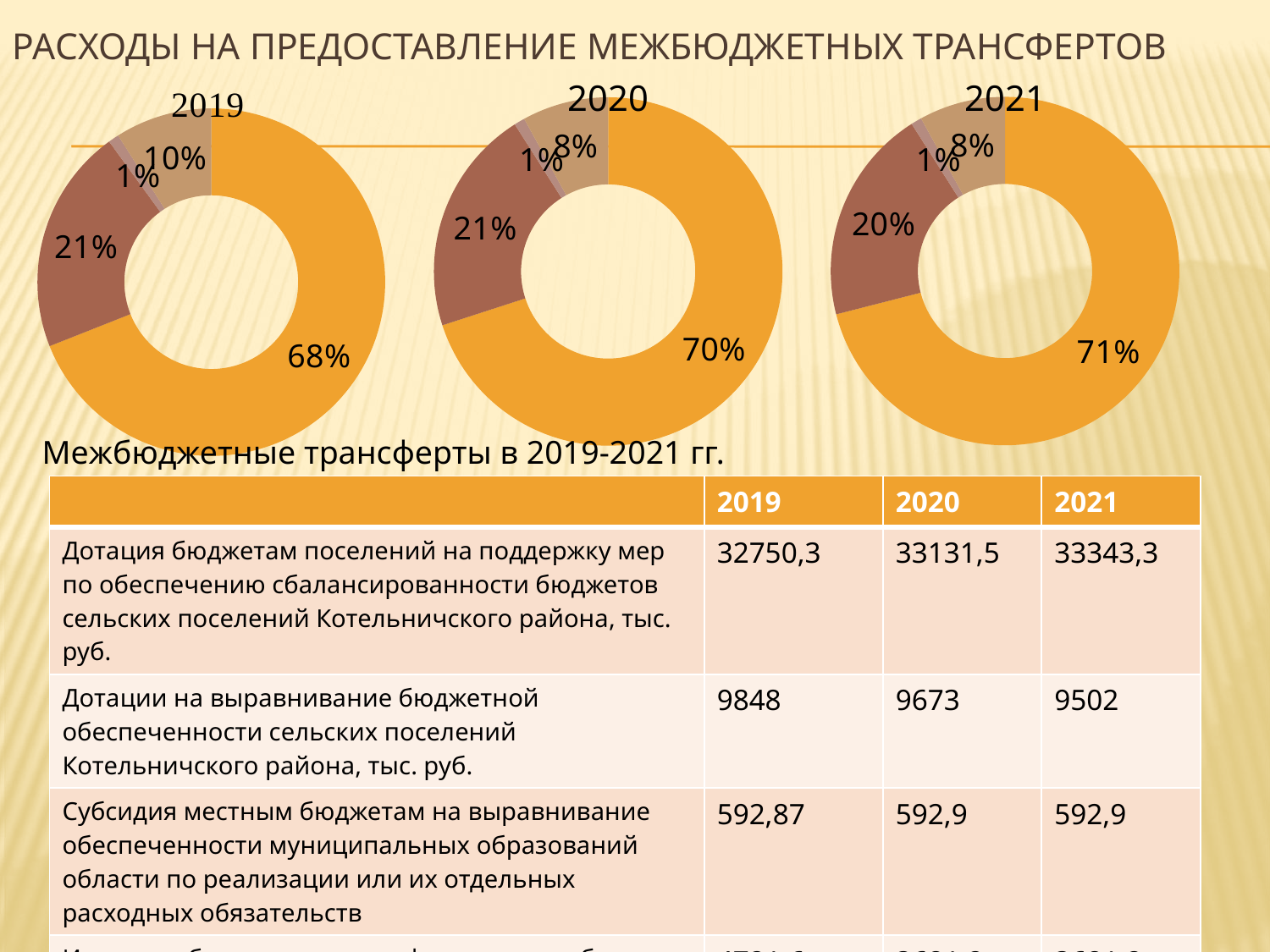
In the 2021 chart, what is the share of the largest slice? 71% In the 2019 chart, what is the share of the smallest slice? 1% Does the share of the largest slice rise or fall from the 2019 chart to the 2021 chart? Rises In the 2019 chart, what is the share of the largest slice? 68% Which chart has the larger share for its largest slice, 2019 or 2021? 2021 In the 2020 chart, what is the share of the largest slice? 70% What kind of chart is used for the 2019, 2020 and 2021 charts on the slide? Doughnut (pie) chart How many slices does the 2020 chart have? 4 What is the difference between the largest slice share in the 2021 chart and the largest slice share in the 2019 chart? 3 percentage points How many charts are shown on the slide? 3 What is the title of the 2019 chart? 2019